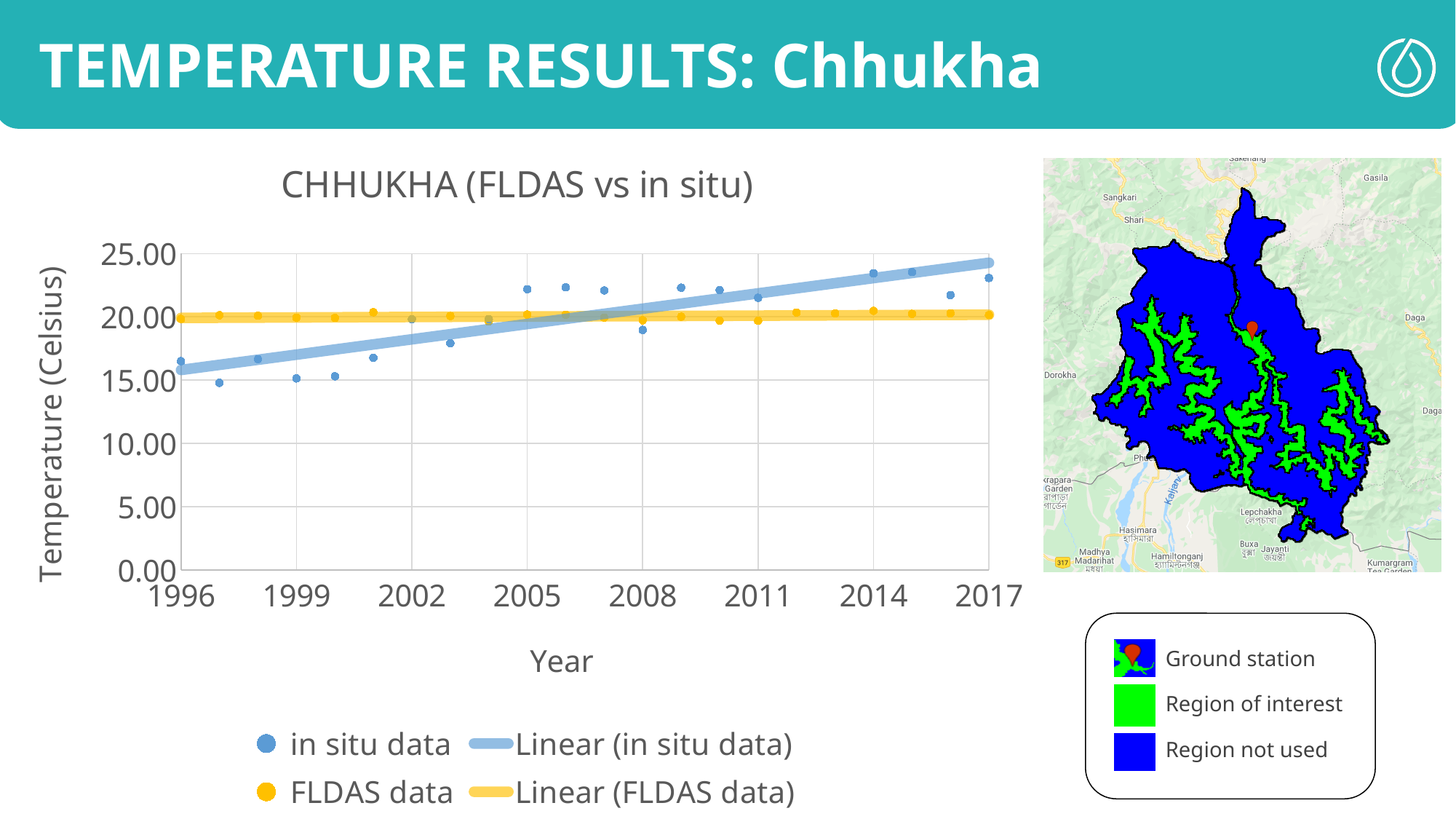
What is the title of the chart? CHHUKHA (FLDAS vs in situ) Is the in situ data value for 2017 greater or less than 20.00? greater What kind of chart is shown on the slide? scatter chart How many entries does the chart legend list? 4 What is the label of the vertical axis? Temperature (Celsius) In 1996, which is larger: the in situ data value or the FLDAS data value? FLDAS data Do the in situ data values generally rise or fall from 1996 to 2017? rise Is the in situ data value for 2005 greater or less than 20.00? greater In 2017, which is larger: the in situ data value or the FLDAS data value? in situ data Is the in situ data value for 2008 greater or less than 20.00? less What is the highest value shown on the vertical axis? 25.00